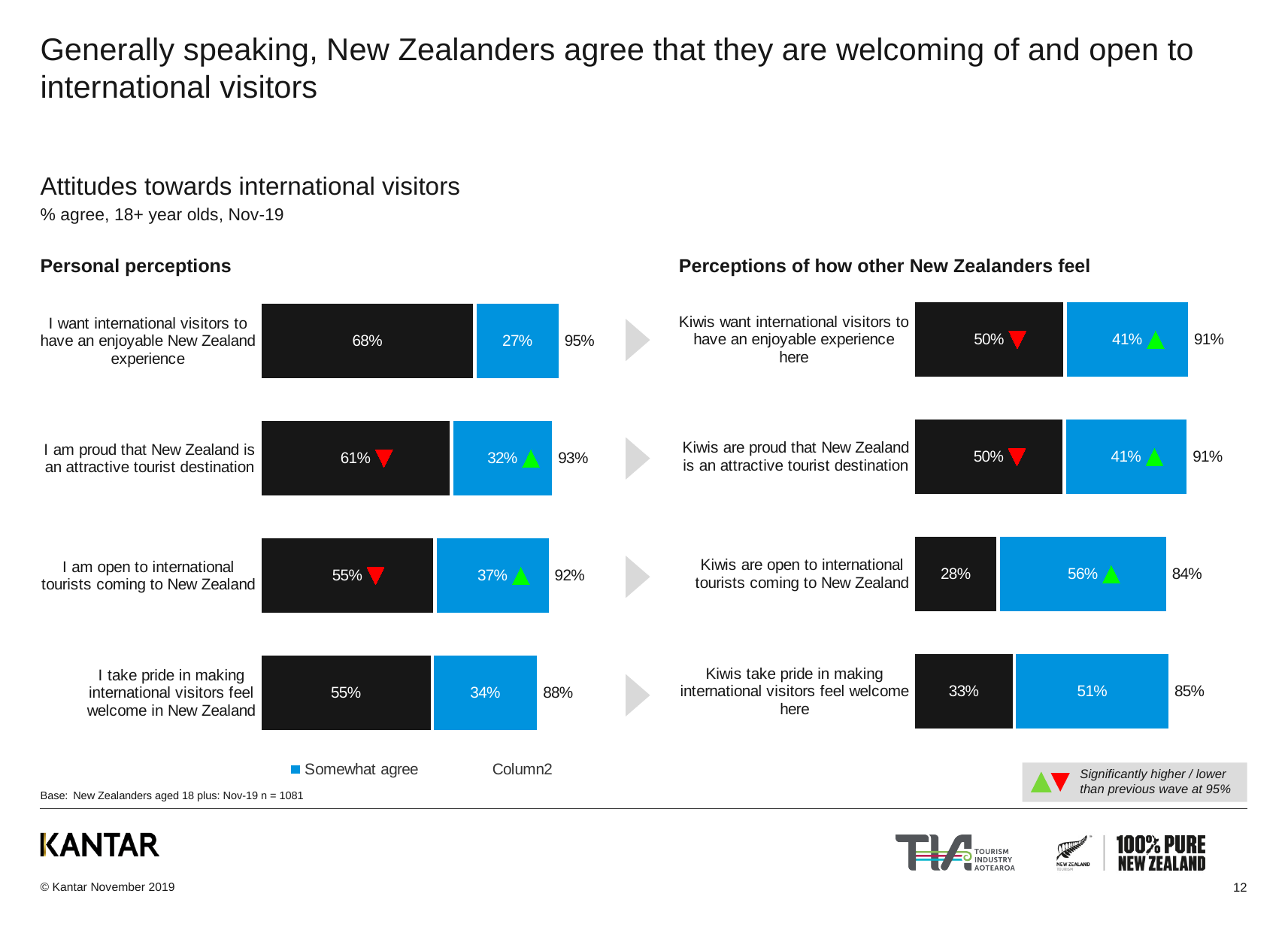
In the Personal perceptions chart, what is the total shown for 'I take pride in making international visitors feel welcome in New Zealand'? 88% In the Personal perceptions chart, which statement has the highest total percentage? I want international visitors to have an enjoyable New Zealand experience What kind of chart is used for the Personal perceptions data? Stacked bar chart In the Personal perceptions chart, what is the 'Somewhat agree' value for 'I am open to international tourists coming to New Zealand'? 37% How many entries does the legend at the bottom of the slide list? 2 How many statements are plotted in the Personal perceptions chart? 4 In the Perceptions of how other New Zealanders feel chart, which has the larger 'Somewhat agree' value: 'Kiwis are open to international tourists coming to New Zealand' or 'Kiwis take pride in making international visitors feel welcome here'? Kiwis are open to international tourists coming to New Zealand According to the note on the slide, what do the green and red triangles next to the values indicate? Significantly higher / lower than previous wave at 95% In the Personal perceptions chart, what is the difference between the total for 'I want international visitors to have an enjoyable New Zealand experience' and the total for 'I take pride in making international visitors feel welcome in New Zealand'? 7 percentage points In the Perceptions of how other New Zealanders feel chart, which statement has the lowest total percentage? Kiwis are open to international tourists coming to New Zealand In the Perceptions of how other New Zealanders feel chart, what value is shown in the black segment for 'Kiwis take pride in making international visitors feel welcome here'? 33% In the Perceptions of how other New Zealanders feel chart, what is the difference between the blue segment (56%) and the black segment (28%) for 'Kiwis are open to international tourists coming to New Zealand'? 28 percentage points